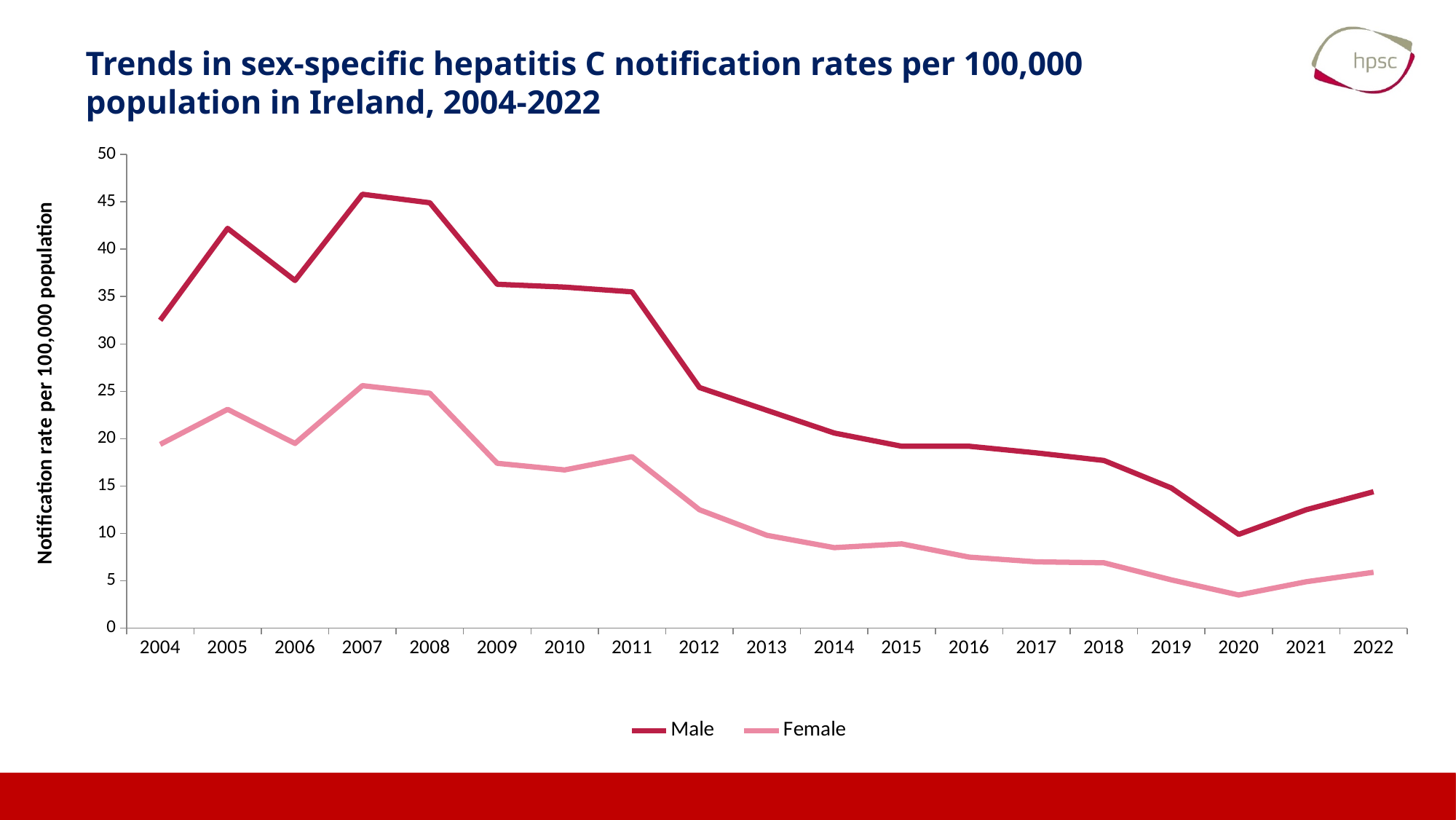
Is the Female notification rate in 2020 greater or less than 5? less How many series does the legend list? 2 What is the label on the y axis? Notification rate per 100,000 population What kind of chart is shown on the slide? Line chart Does the Male notification rate rise or fall between 2012 and 2020? Fall Which is larger, the Male notification rate in 2005 or in 2006? 2005 Is the Female notification rate in 2007 greater or less than 20? greater Is the Male notification rate in 2004 greater or less than 30? greater How many years are plotted along the x axis? 19 In which year is the Male notification rate lowest? 2020 In which year is the Female notification rate lowest? 2020